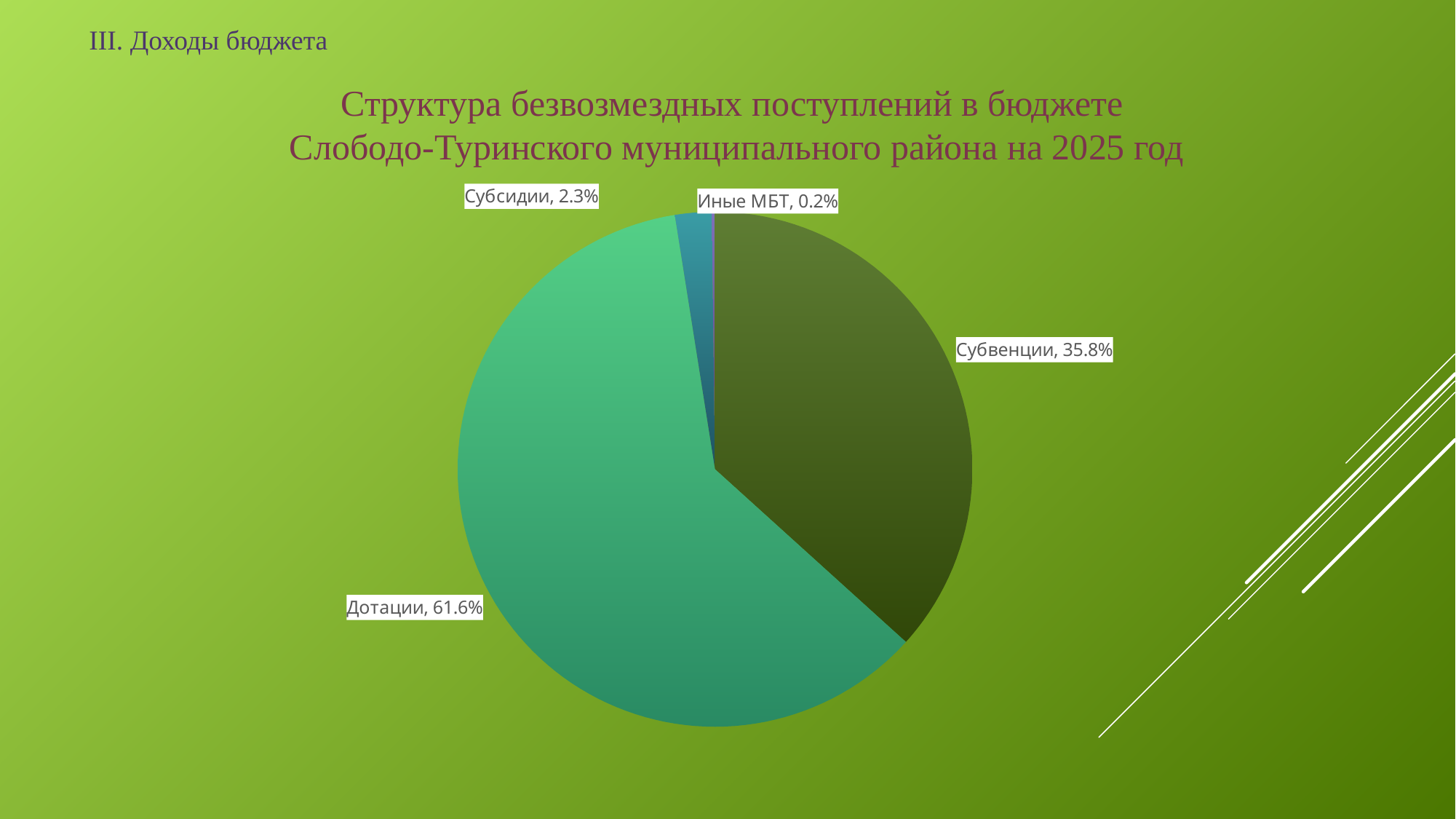
Which category has the largest slice of the pie? Дотации Which is larger, the share of Субсидии or the share of Иные МБТ? Субсидии What is the combined share of Субсидии and Иные МБТ? 2.5% What is the value shown for Субвенции? 35.8% What is the value shown for Иные МБТ? 0.2% What is the value shown for Субсидии? 2.3% What is the difference between the shares of Дотации and Субвенции? 25.8% What share of the pie does Дотации have? 61.6% Which category has the smallest slice of the pie? Иные МБТ How many categories are shown in the pie chart? 4 What is the title of the chart? Структура безвозмездных поступлений в бюджете Слободо-Туринского муниципального района на 2025 год What kind of chart is shown on the slide? Pie chart